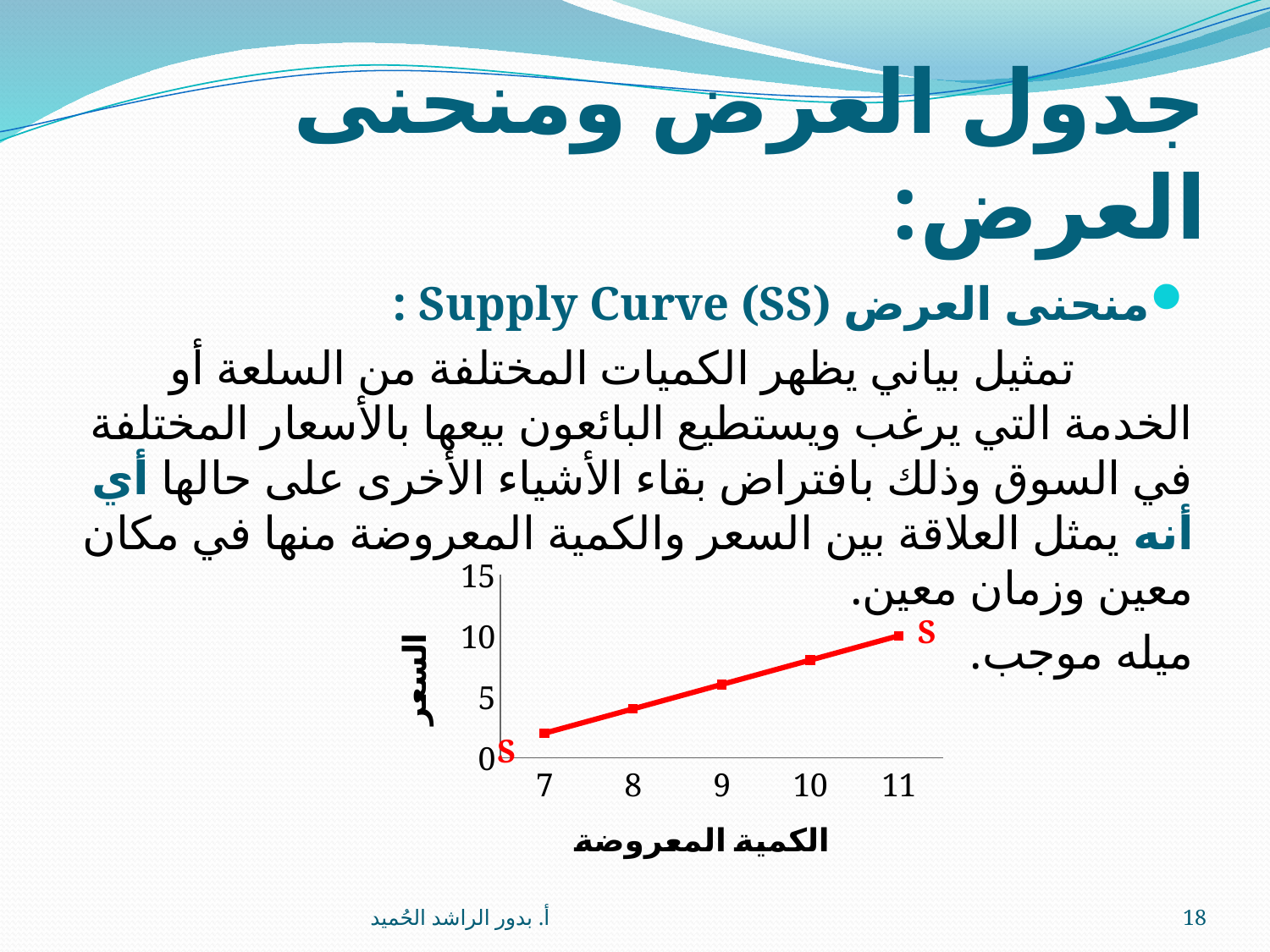
Do the values rise or fall as the quantity supplied increases along the x axis? rise What is the title of the x axis of the chart? الكمية المعروضة Is the price value at a quantity supplied of 7 greater or less than 5? less Is the price value at a quantity supplied of 9 greater or less than 10? less Which quantity supplied has the highest price on the curve? 11 What is the price value at a quantity supplied of 11? 10 Which has the larger price value: quantity supplied 8 or quantity supplied 10? 10 Is the price value at a quantity supplied of 10 greater or less than 5? greater What kind of chart is shown on the slide? line chart Which quantity supplied has the lowest price on the curve? 7 What letter labels the plotted supply line on the chart? S How many data points are plotted on the supply curve? 5